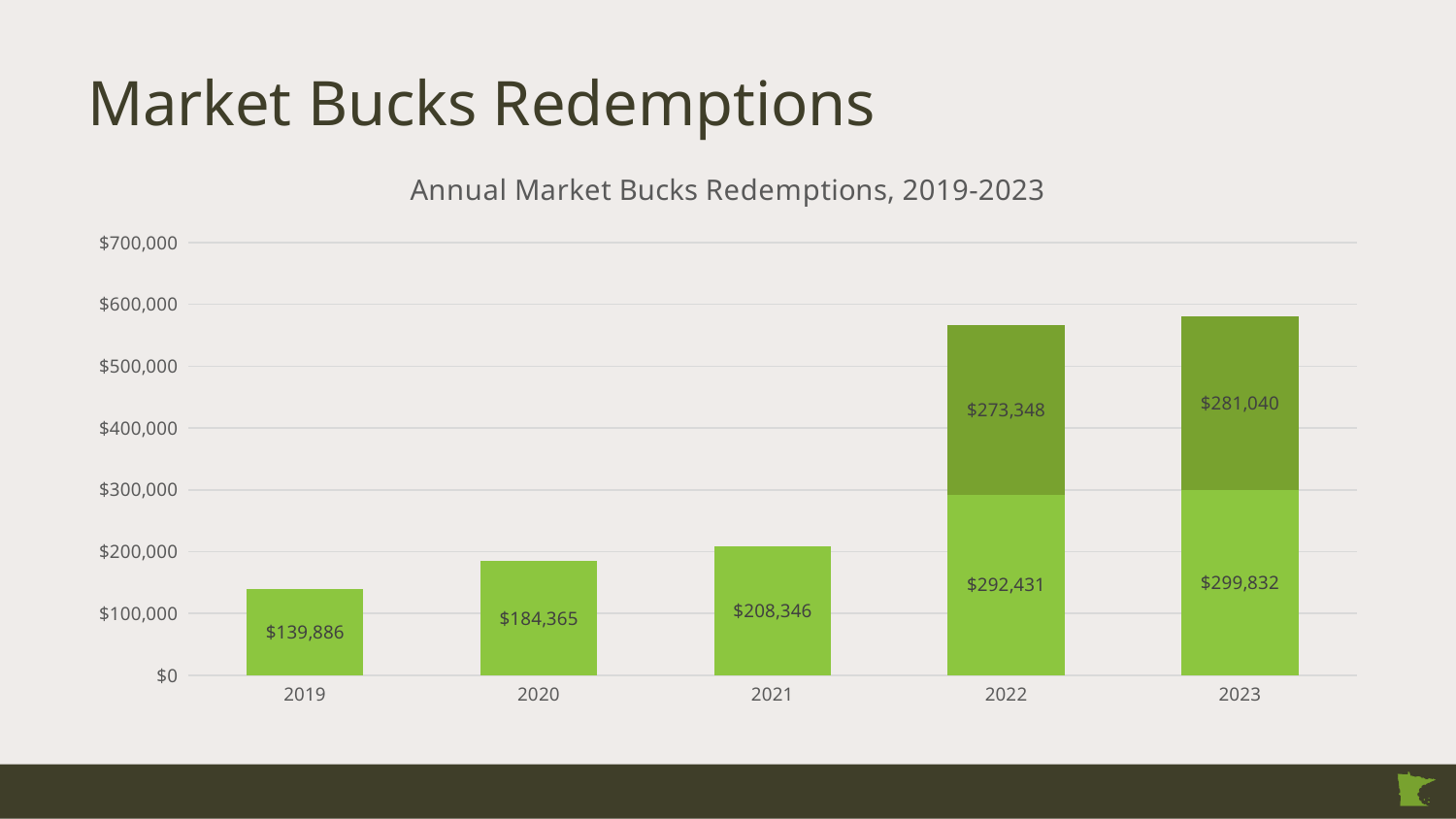
What is the difference between the 2020 value and the 2019 value? $44,479 What is the value shown for 2019? $139,886 What is the value of the lower (light green) segment of the 2022 bar? $292,431 What is the value of the upper (dark green) segment of the 2023 bar? $281,040 How many years are shown on the x axis? 5 Do the bar heights rise or fall from 2019 to 2023? rise Which year has the shortest bar? 2019 What is the total of the 2022 stacked bar? $565,779 What is the total of the 2023 stacked bar? $580,872 Is the value for 2019 greater or less than $100,000? greater Which year has the tallest bar? 2023 What is the value shown for 2021? $208,346